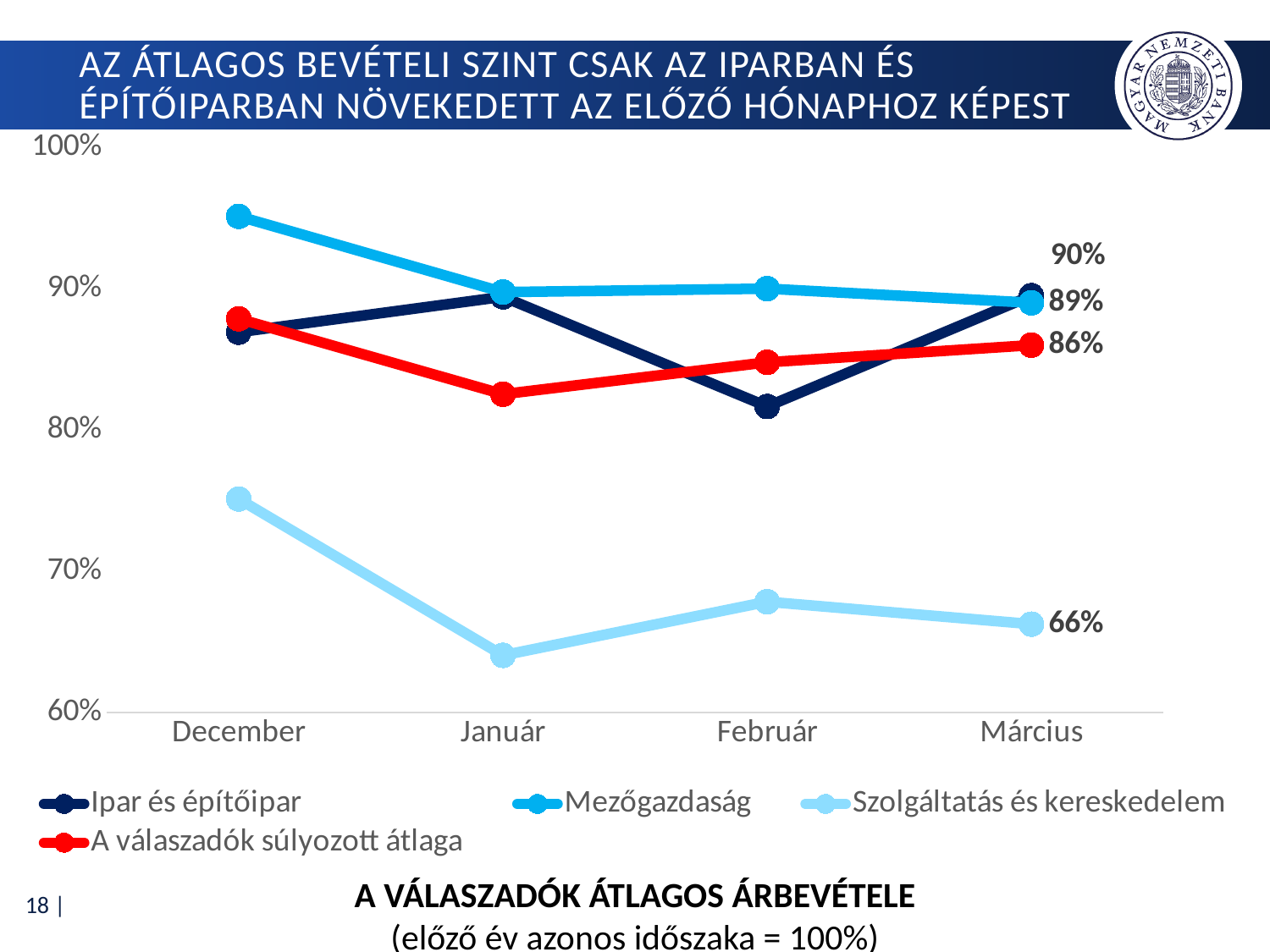
Which series has the lowest value in Március? Szolgáltatás és kereskedelem What is the value for Mezőgazdaság in Március? 89% What is the value for Ipar és építőipar in Március? 90% Is the value for Szolgáltatás és kereskedelem in December greater or less than 80%? less What is the value for Szolgáltatás és kereskedelem in Március? 66% Does the Szolgáltatás és kereskedelem line rise or fall from December to Január? fall How many months are shown on the x axis? 4 How many series does the legend list? 4 Which is larger in Február: Ipar és építőipar or Mezőgazdaság? Mezőgazdaság What is the value for A válaszadók súlyozott átlaga in Március? 86% What kind of chart is shown on the slide? line chart What is the difference between Ipar és építőipar and Szolgáltatás és kereskedelem in Március? 24 percentage points